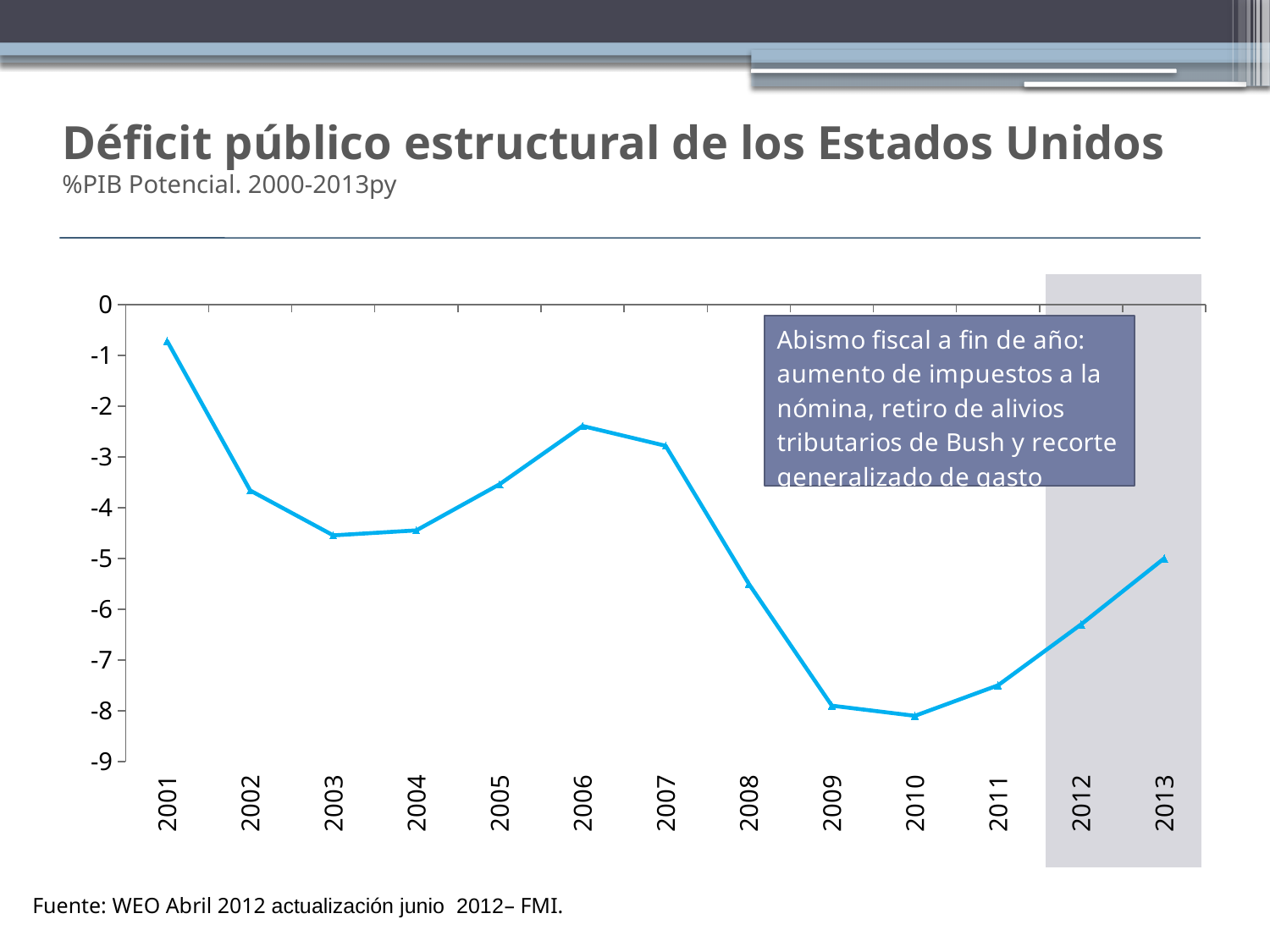
Is the value for 2009 greater or less than -7? less What kind of chart is shown on the slide? line chart Which years on the chart are highlighted with a grey shaded background? 2012 and 2013 Is the value for 2012 greater or less than -6? less Do the values rise or fall from 2007 to 2010? fall Which is larger, the value for 2006 or the value for 2007? 2006 Which year has the highest value (closest to 0) on the chart? 2001 How many years are plotted on the x axis of the chart? 13 Is the value for 2006 greater or less than -3? greater Do the values rise or fall from 2010 to 2013? rise